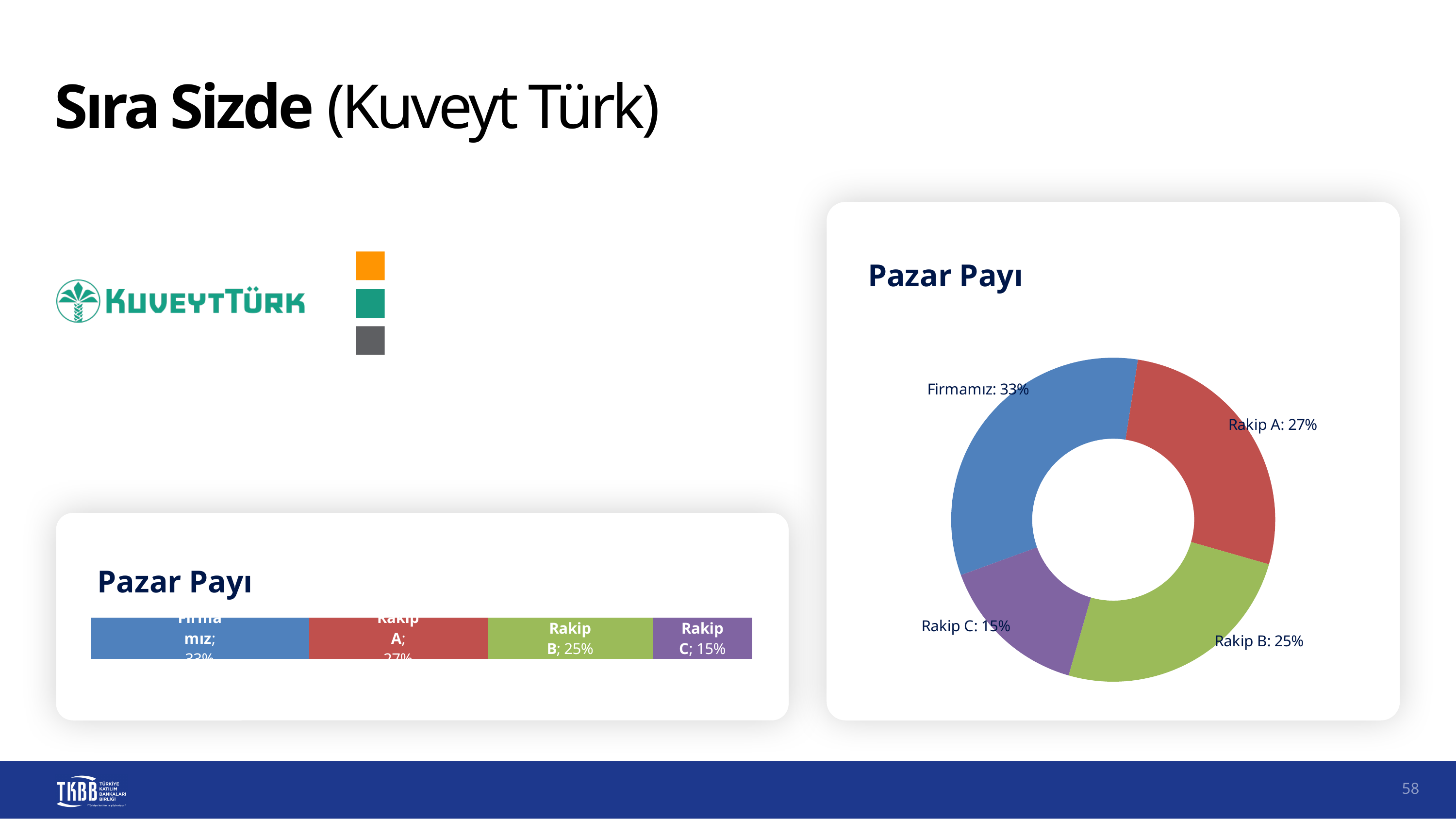
How many categories are shown in the doughnut chart on the right? 4 What is the title of the doughnut chart on the right? Pazar Payı In the stacked bar chart at the bottom left, what is the value for Rakip C? 15% In the doughnut chart on the right, which is larger, the share of Rakip A or the share of Rakip B? Rakip A In the doughnut chart on the right, which category has the largest share? Firmamız In the doughnut chart on the right, what is the share for Rakip A? 27% In the doughnut chart on the right, what is the share for Firmamız? 33% In the doughnut chart on the right, what is the difference between the shares of Firmamız and Rakip C? 18% What kind of chart is the chart at the bottom left of the slide? Stacked bar chart In the stacked bar chart at the bottom left, what is the value for Rakip B? 25% What kind of chart is the chart on the right of the slide? Doughnut chart In the doughnut chart on the right, which category has the smallest share? Rakip C